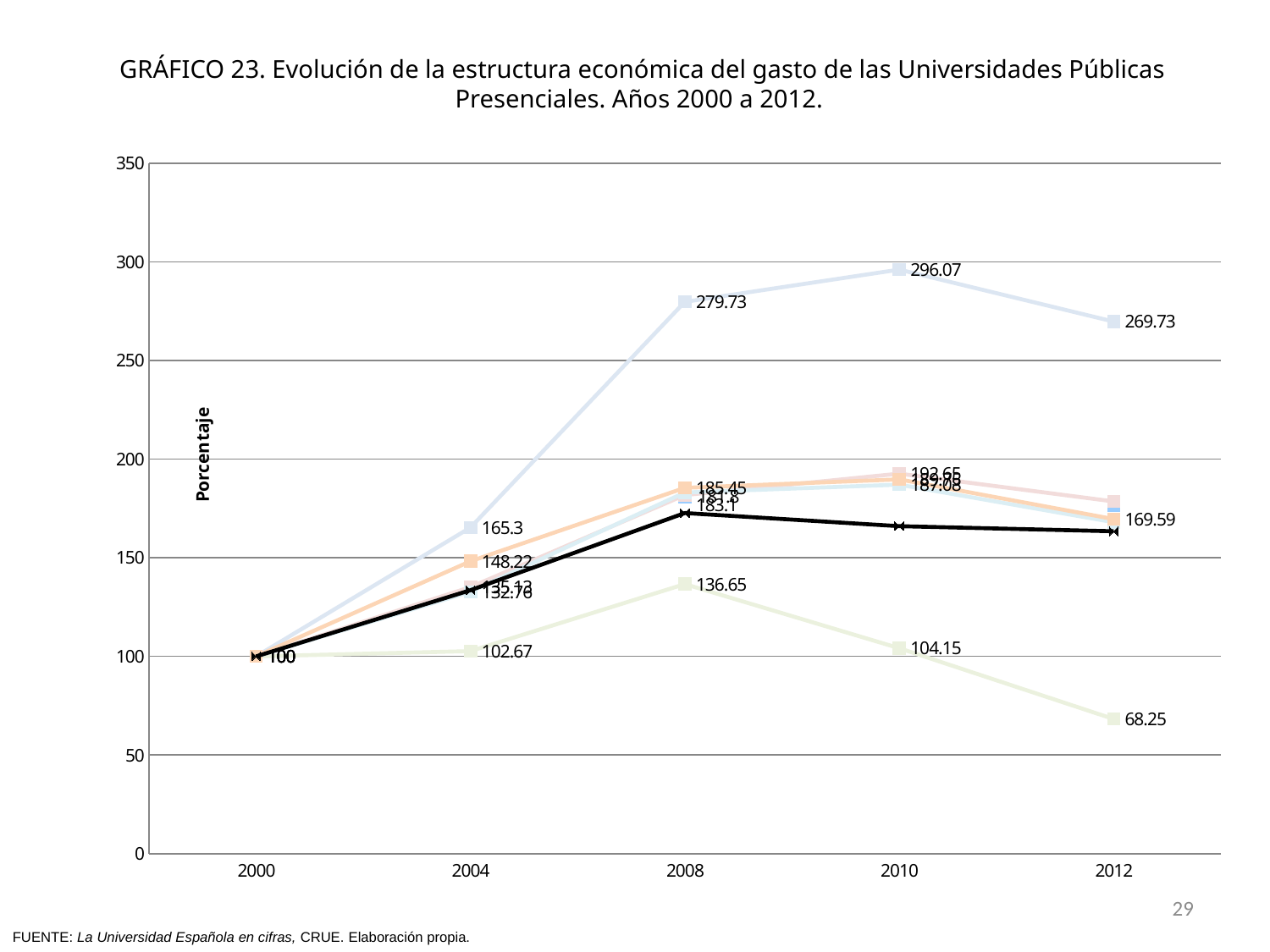
Does the light green line rise or fall from 2008 to 2012? fall How many years are shown on the x axis? 5 What is the value of the light blue line in 2010? 296.07 What is the difference between the light blue line's values in 2010 and 2012? 26.34 In which year does the light green line reach its lowest value? 2012 Is the value of the black line in 2012 greater or less than 200? less What is the value of the light green line in 2012? 68.25 What is the value of the light blue line in 2008? 279.73 What is the label of the y axis? Porcentaje In which year does the light blue line reach its highest value? 2010 What kind of chart is shown on the slide? line chart What is the value of the light green line in 2004? 102.67